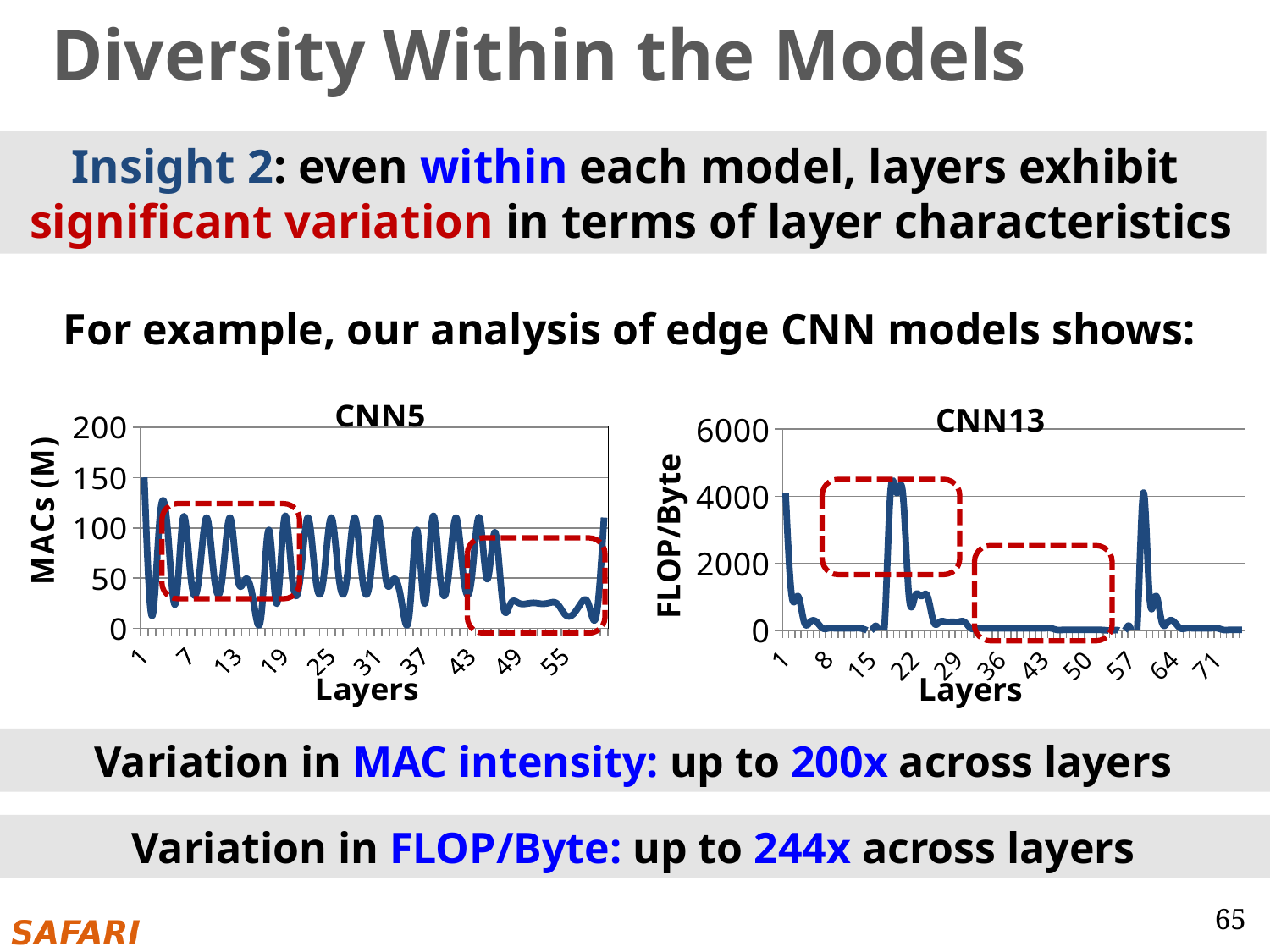
In the CNN5 chart, is the value for layer 1 greater or less than 100? greater In the CNN13 chart, is the value for layer 43 greater or less than 2000? less What kind of chart is the CNN13 chart on the right? Line chart How many labelled ticks are on the x axis of the CNN13 chart? 11 In the CNN13 chart, is the value for layer 8 greater or less than 2000? less What is the y-axis label of the CNN5 chart? MACs (M) In the CNN13 chart, which is larger, the value for layer 1 or the value for layer 43? Layer 1 In the CNN13 chart, do the values rise or fall from layer 1 to layer 8? fall What is the highest tick value on the y axis of the CNN13 chart? 6000 What kind of chart is the CNN5 chart on the left? Line chart In the CNN5 chart, which is larger, the value for layer 1 or the value for layer 55? Layer 1